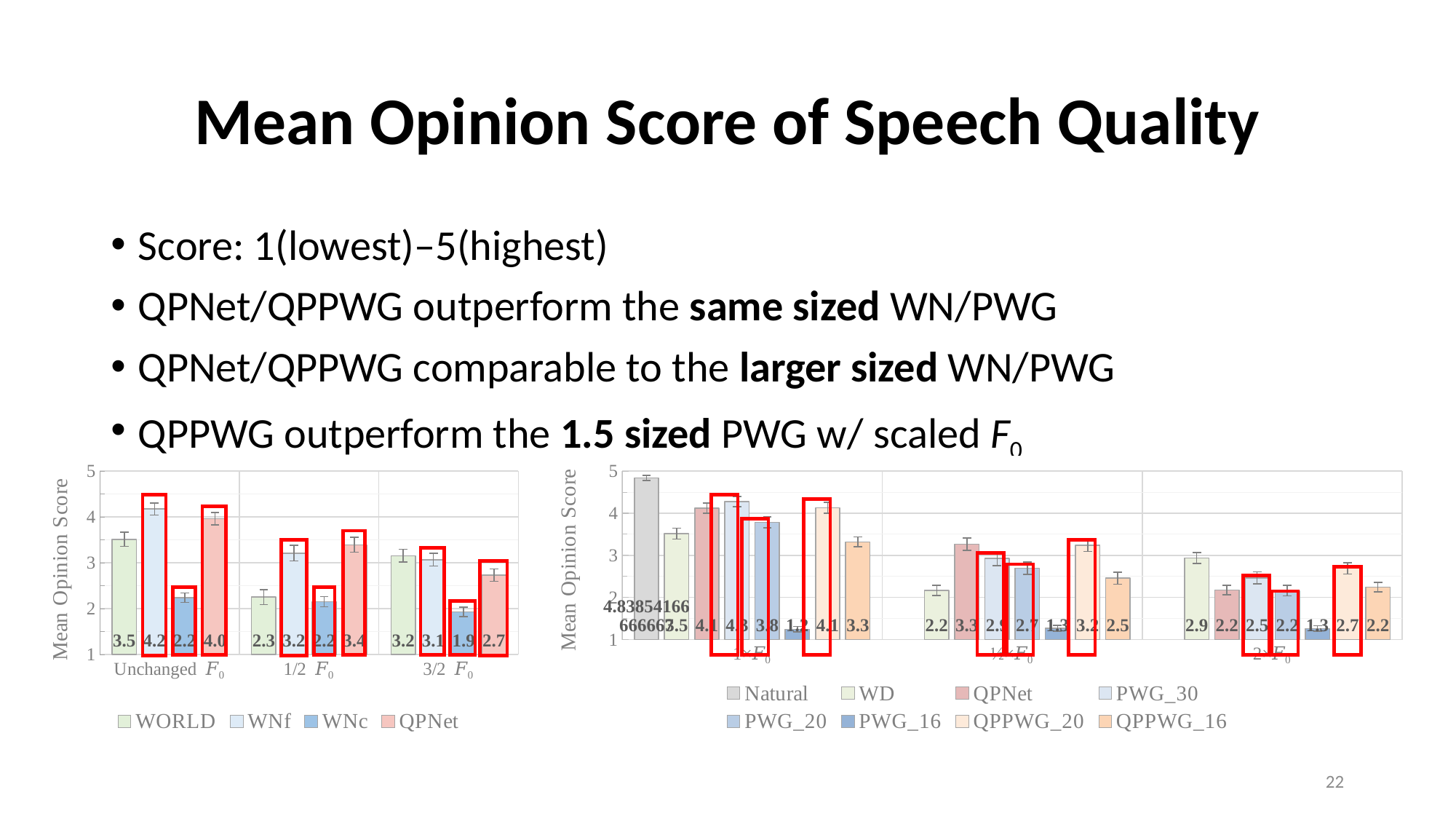
In the left chart, does the WORLD score rise or fall from Unchanged F0 to 1/2 F0? fall In the right chart, which series has the highest score at 1×F0? Natural In the left chart, what is the difference between the WNf and WNc scores at Unchanged F0? 2.0 In the left chart, what is the Mean Opinion Score for QPNet at 1/2 F0? 3.4 In the right chart, what is the Mean Opinion Score for PWG_16 at 1×F0? 1.2 In the right chart, how many series does the legend list? 8 In the left chart, which series has the lowest score at 3/2 F0? WNc In the left chart, how many series does the legend list? 4 In the right chart, which is larger at 2×F0: QPPWG_20 or PWG_20? QPPWG_20 In the left chart, what is the Mean Opinion Score for WNf at Unchanged F0? 4.2 What type of chart is the right chart? bar chart In the right chart, what is the Mean Opinion Score for QPPWG_20 at ½×F0? 3.2